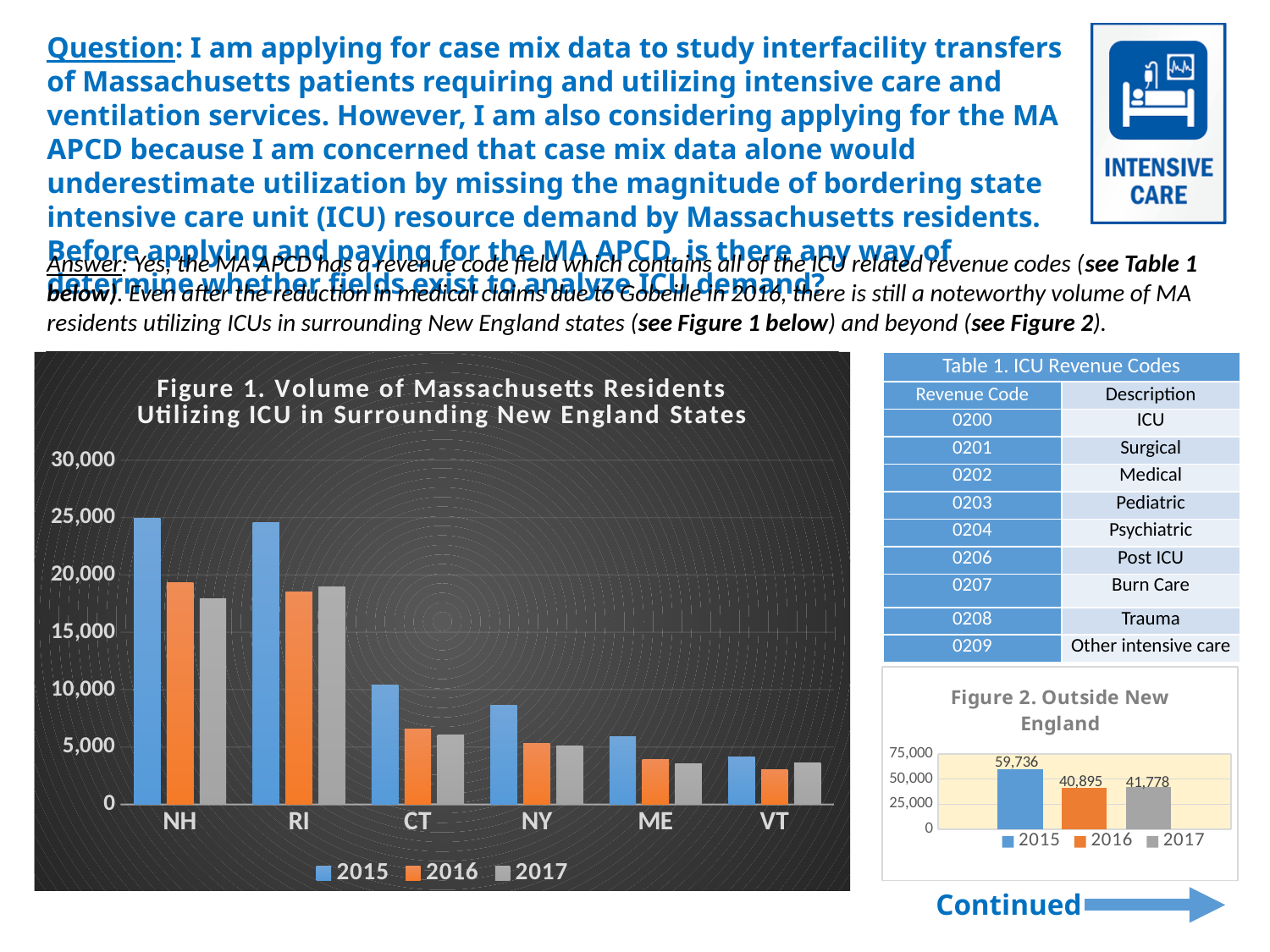
In Figure 2 (Outside New England), what is the value for 2017? 41,778 In Figure 2 (Outside New England), what is the difference between the 2015 and 2016 values? 18,841 How many states are shown on the x axis of Figure 1? 6 In Figure 2 (Outside New England), which year has the highest value? 2015 In Figure 2 (Outside New England), what is the value for 2016? 40,895 How many series does the legend of Figure 1 list? 3 In Figure 1, which is larger: the 2015 value for CT or the 2015 value for NY? CT In Figure 2 (Outside New England), which year has the lowest value? 2016 In Figure 1, do the 2015 values rise or fall moving from NH to VT along the x axis? fall In Figure 1, is the 2015 value for NH greater or less than 20,000? greater In Figure 2 (Outside New England), what is the value for 2015? 59,736 What kind of chart is Figure 1 (Volume of Massachusetts Residents Utilizing ICU in Surrounding New England States)? bar chart